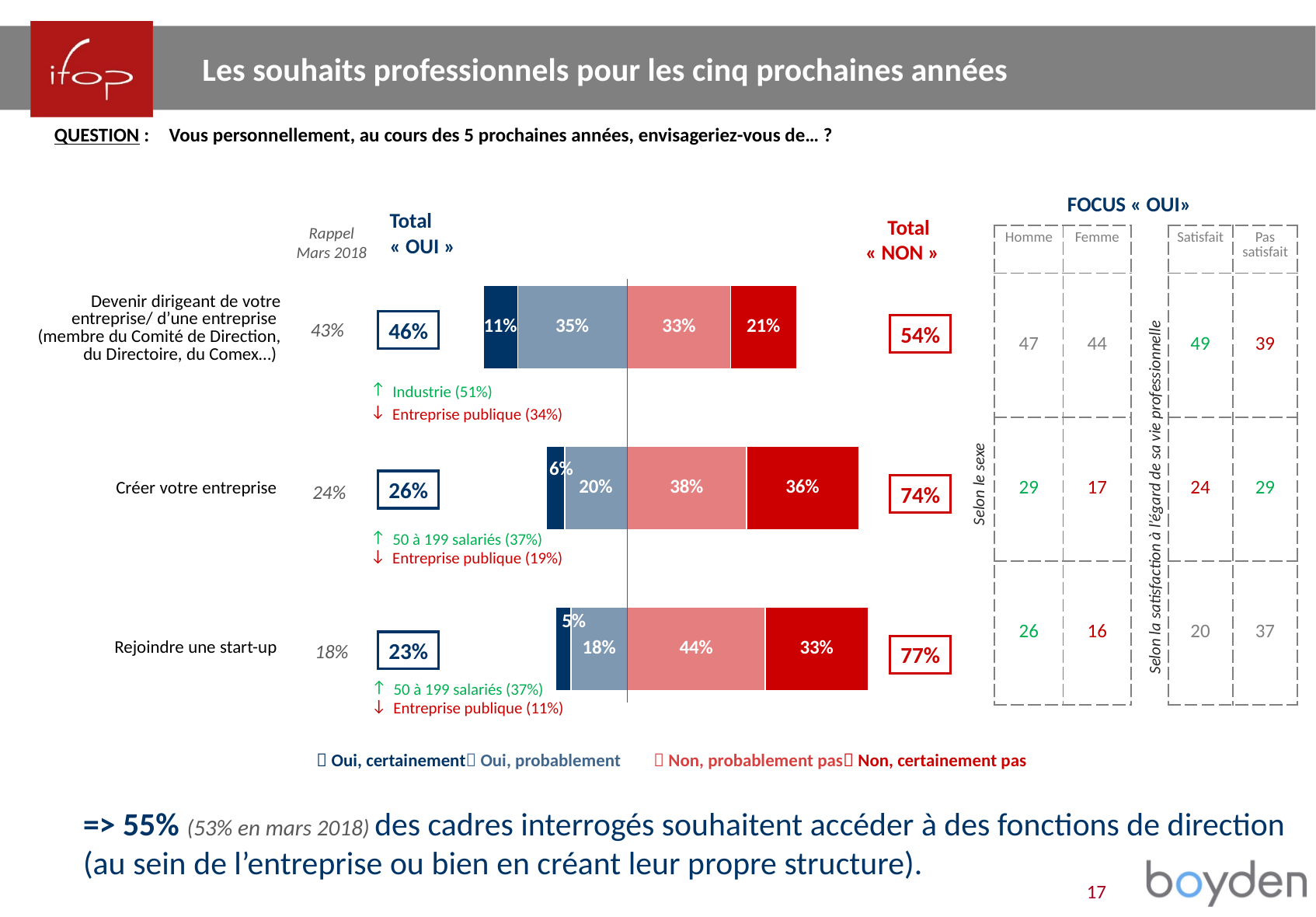
How many categories (professional wishes) are plotted in the chart? 3 Which is larger: the 'Non, probablement pas' value for 'Créer votre entreprise' or for 'Rejoindre une start-up'? Rejoindre une start-up What is the 'Oui, probablement' value for 'Devenir dirigeant de votre entreprise/ d'une entreprise'? 35% What was the Rappel Mars 2018 value for 'Créer votre entreprise'? 24% What is the Total « OUI » for 'Rejoindre une start-up'? 23% Which category has the highest Total « OUI »? Devenir dirigeant de votre entreprise/ d'une entreprise What is the 'Non, certainement pas' value for 'Créer votre entreprise'? 36% Which category has the lowest 'Oui, certainement' value? Rejoindre une start-up What is the 'Non, probablement pas' value for 'Rejoindre une start-up'? 44% How many series does the legend list? 4 What is the difference between the Total « NON » for 'Rejoindre une start-up' and for 'Devenir dirigeant de votre entreprise/ d'une entreprise'? 23 points What kind of chart is shown on the slide? Stacked bar chart